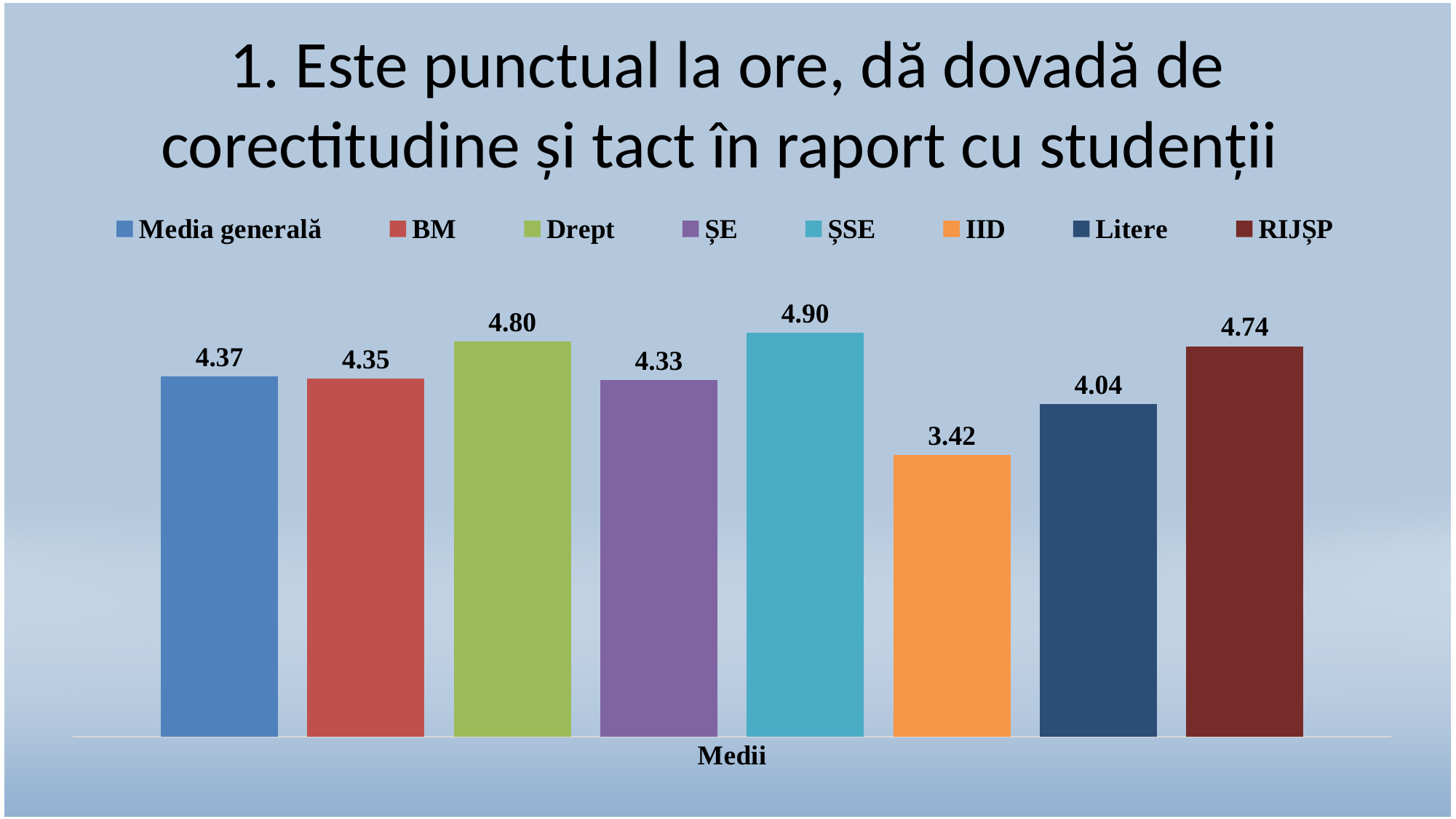
What is the difference between the values for ȘSE and IID? 1.48 What is the value for Media generală? 4.37 Which series has the lowest value? IID What is the label shown on the x axis? Medii What is the value for IID? 3.42 What is the difference between the values for RIJȘP and Litere? 0.70 What kind of chart is shown on the slide? Bar chart Which is larger, the value for Drept or the value for RIJȘP? Drept What is the value for Drept? 4.80 What is the value for Litere? 4.04 Which series has the highest value? ȘSE How many series does the legend list? 8